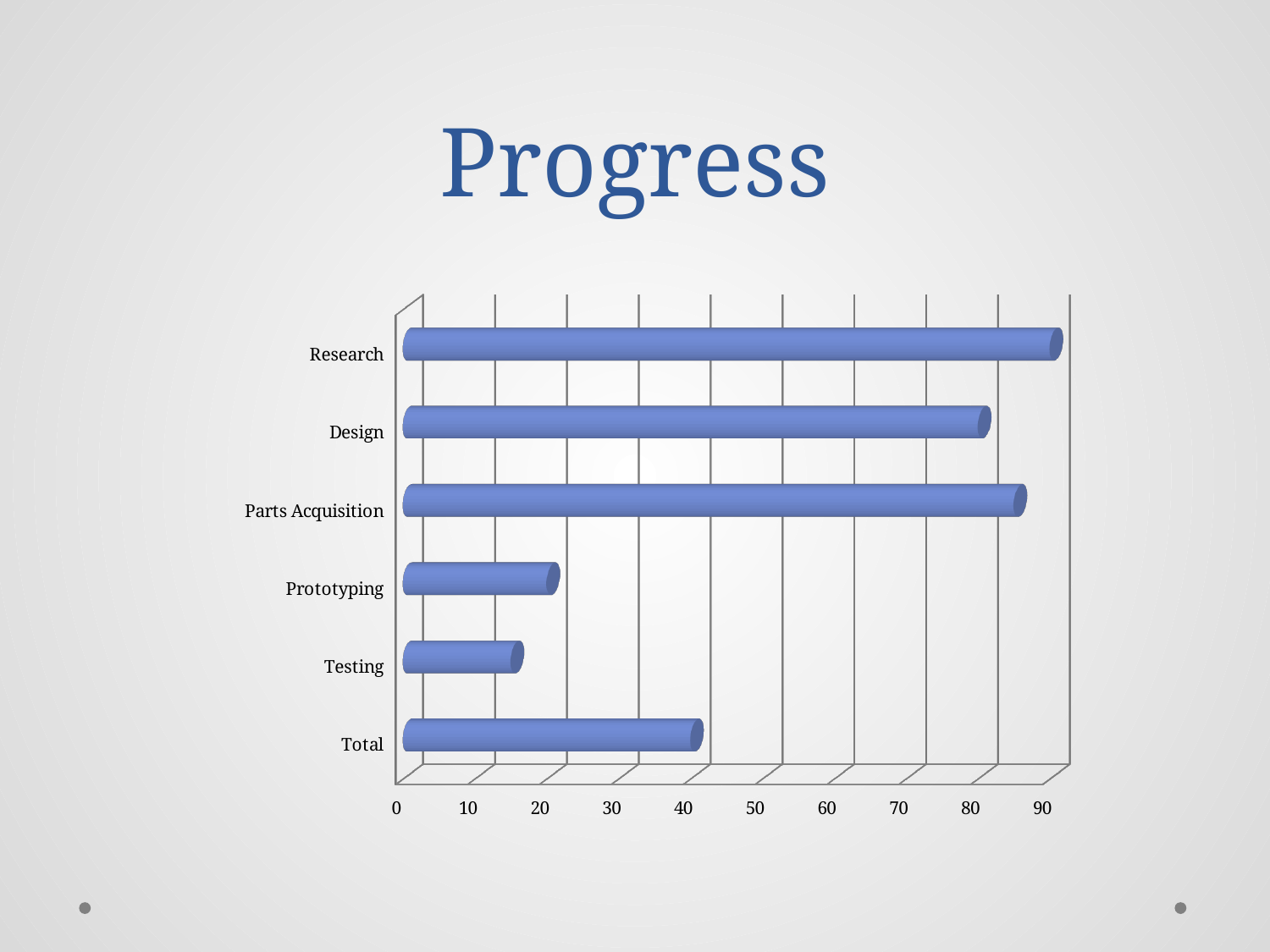
Is the value for Prototyping greater or less than 30? less Is the value for Total greater or less than 50? less What is the title of the slide containing the chart? Progress Is the value for Testing greater or less than 20? less Which category has the longest bar? Research Which category has the shortest bar? Testing Which is larger, the value for Design or the value for Parts Acquisition? Parts Acquisition What kind of chart is shown on the slide? bar chart How many categories are plotted in the chart? 6 Which is larger, the value for Prototyping or the value for Testing? Prototyping